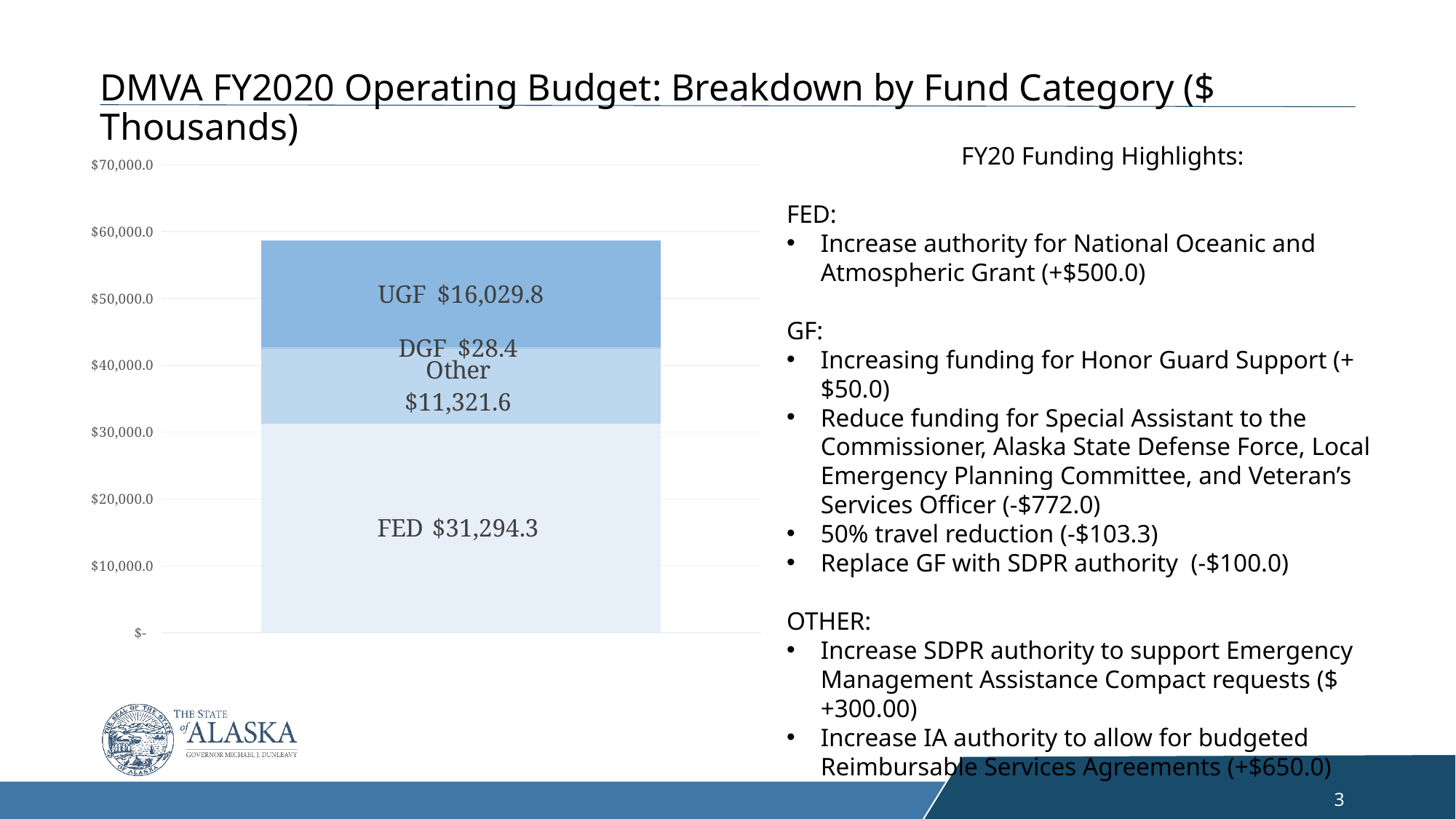
Which fund category has the largest value in the chart? FED What is the value of the UGF segment in the stacked bar? $16,029.8 What type of chart is shown on the slide? Stacked bar chart Which is larger, the UGF value or the Other value? UGF What is the value of the DGF segment in the stacked bar? $28.4 What is the value of the FED segment in the stacked bar? $31,294.3 Is the total height of the stacked bar greater or less than $60,000.0? less How many fund category segments make up the stacked bar? 4 What is the value of the Other segment in the stacked bar? $11,321.6 What is the difference between the FED and UGF values? $15,264.5 What is the total of all segments in the stacked bar? $58,674.1 Which fund category has the smallest value in the chart? DGF